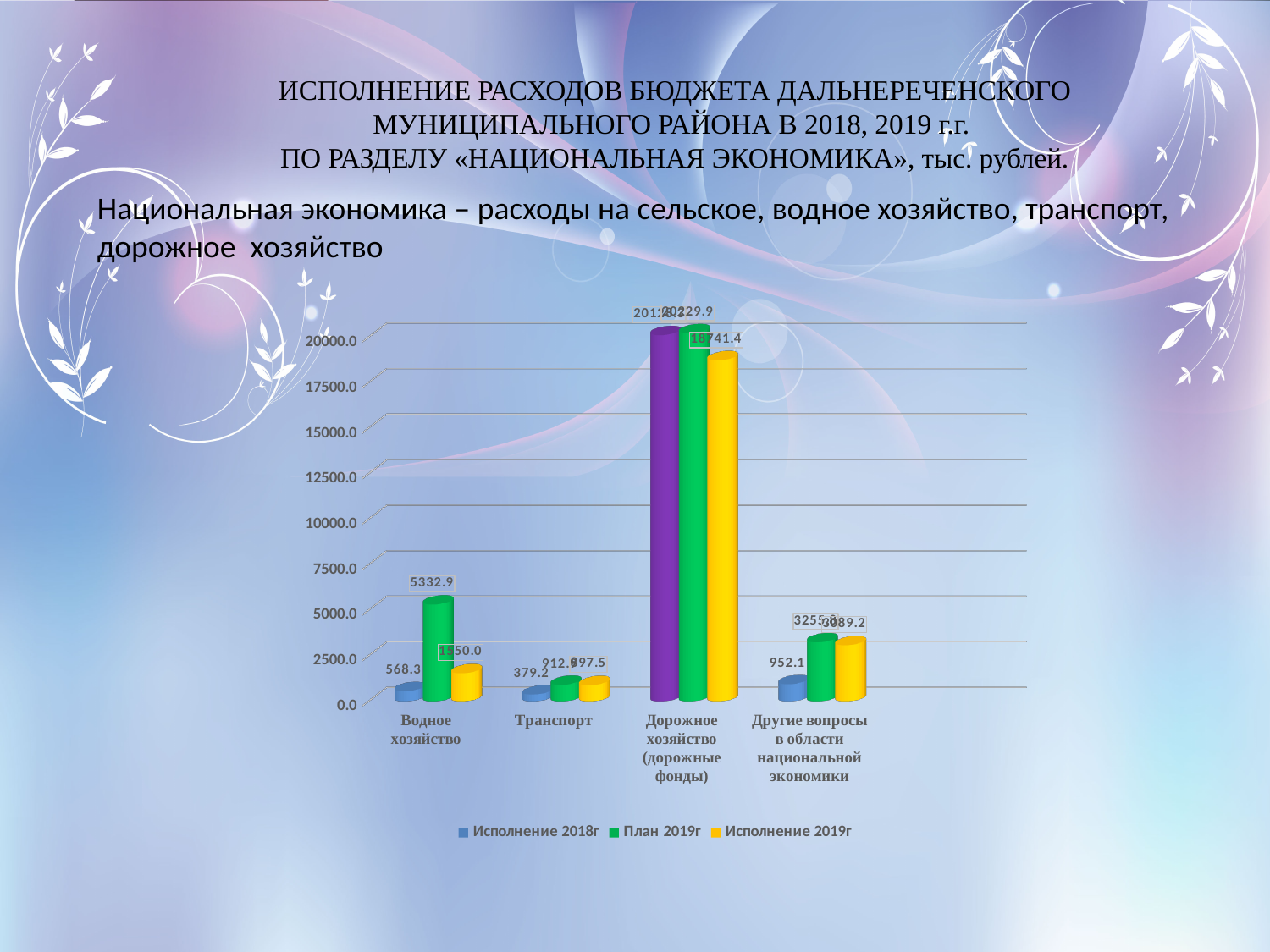
What is the value of Исполнение 2018г for Водное хозяйство? 568.3 Is the value of План 2019г for Дорожное хозяйство (дорожные фонды) greater or less than 20000.0? greater Which category has the lowest value for Исполнение 2018г? Транспорт How many categories are shown on the x axis of the chart? 4 What is the value of План 2019г for Водное хозяйство? 5332.9 How many series does the legend list? 3 What is the difference between План 2019г and Исполнение 2019г for Водное хозяйство? 3782.9 What is the value of Исполнение 2019г for Дорожное хозяйство (дорожные фонды)? 18741.4 What is the value of Исполнение 2019г for Транспорт? 897.5 For Водное хозяйство, which is larger: Исполнение 2018г or Исполнение 2019г? Исполнение 2019г What is the value of Исполнение 2018г for Другие вопросы в области национальной экономики? 952.1 Which category has the highest value for Исполнение 2019г? Дорожное хозяйство (дорожные фонды)